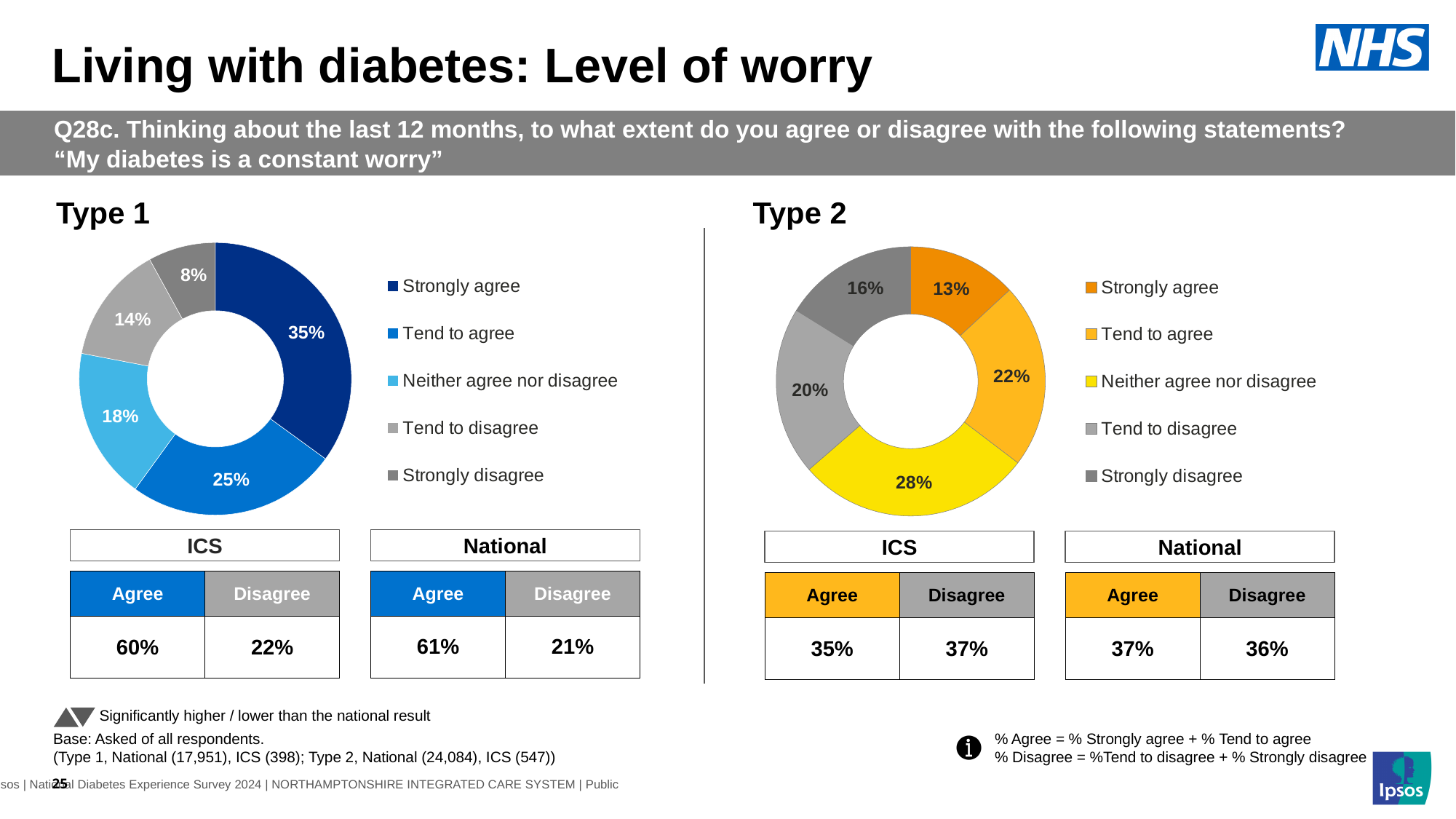
In the Type 2 chart, which category has the largest share? Neither agree nor disagree In the Type 1 chart, which category has the smallest share? Strongly disagree What kind of chart is used for Type 2? Pie chart (doughnut) In the Type 2 chart, what percentage is shown for Neither agree nor disagree? 28% In the Type 1 chart, what percentage is shown for Strongly agree? 35% In the Type 2 chart, what is the difference between the Strongly disagree and Strongly agree percentages? 3% In the Type 2 chart, what percentage is shown for Strongly disagree? 16% In the Type 1 chart, what is the combined share of Strongly agree and Tend to agree? 60% What colour represents Strongly agree in the Type 2 chart? Dark orange In the Type 2 chart, which is larger: Tend to agree or Tend to disagree? Tend to agree In the Type 1 chart, what is the difference between the Tend to agree and Tend to disagree percentages? 11% How many categories does the legend of the Type 1 chart list? 5